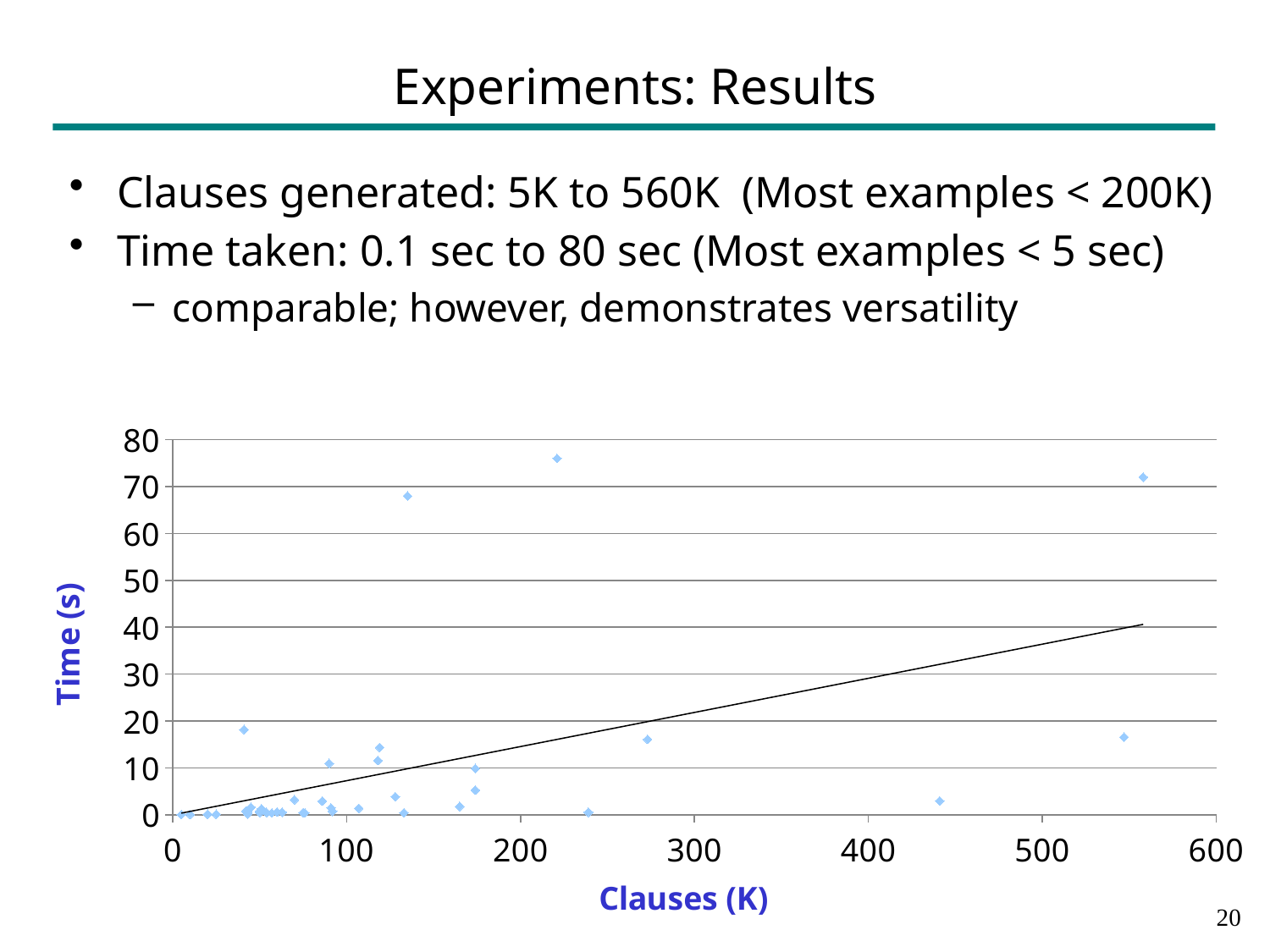
Is the time for the point at roughly 135K clauses greater or less than 60 seconds? greater Is the time for the point at roughly 275K clauses greater or less than 10 seconds? greater Is the time for the point at roughly 440K clauses greater or less than 10 seconds? less What kind of chart is shown on the slide? scatter chart What is the title of the horizontal axis of the chart? Clauses (K) What is the highest value shown on the vertical axis of the chart? 80 Does the fitted line on the chart rise or fall as the number of clauses increases? rises Which is larger: the time for the point at roughly 220K clauses or the time for the point at roughly 275K clauses? the point at roughly 220K clauses What is the title of the vertical axis of the chart? Time (s)